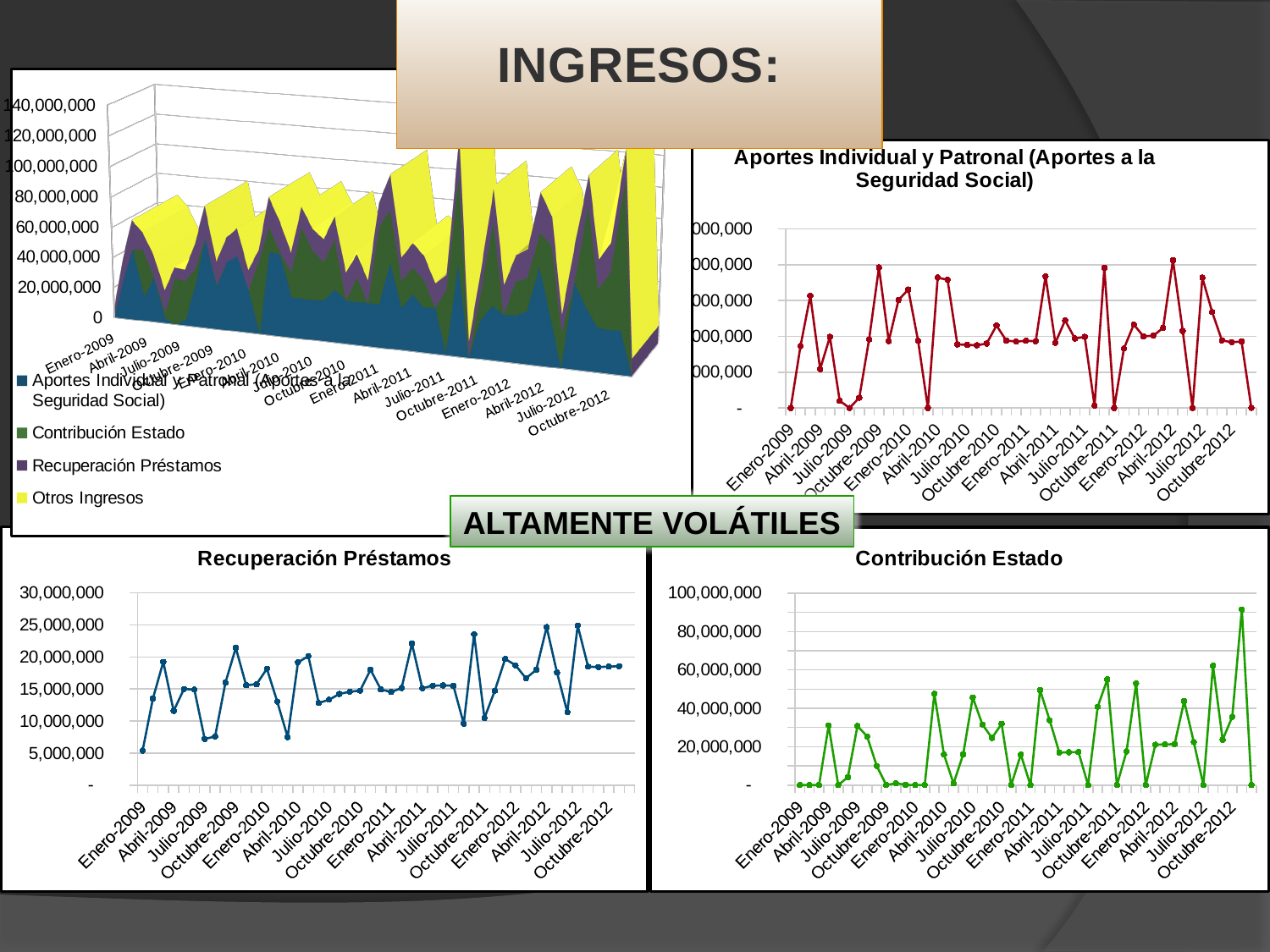
In the 'Contribución Estado' chart, which is larger, the value for Octubre-2012 or the value for Enero-2009? Octubre-2012 What kind of chart is the 'Contribución Estado' chart? Line chart In the top-left area chart, which series is shown in yellow? Otros Ingresos In the 'Contribución Estado' chart, is the value for Abril-2010 greater or less than 40,000,000? less What kind of chart is the large chart in the top-left of the slide? Area chart In the 'Recuperación Préstamos' chart, is the value for Octubre-2012 greater or less than 15,000,000? greater What kind of chart is the 'Recuperación Préstamos' chart? Line chart In the 'Recuperación Préstamos' chart, is the value for Enero-2009 greater or less than 10,000,000? less How many charts are shown on the slide? 4 How many series does the legend of the top-left area chart list? 4 What is the highest value shown on the vertical axis of the top-left area chart? 140,000,000